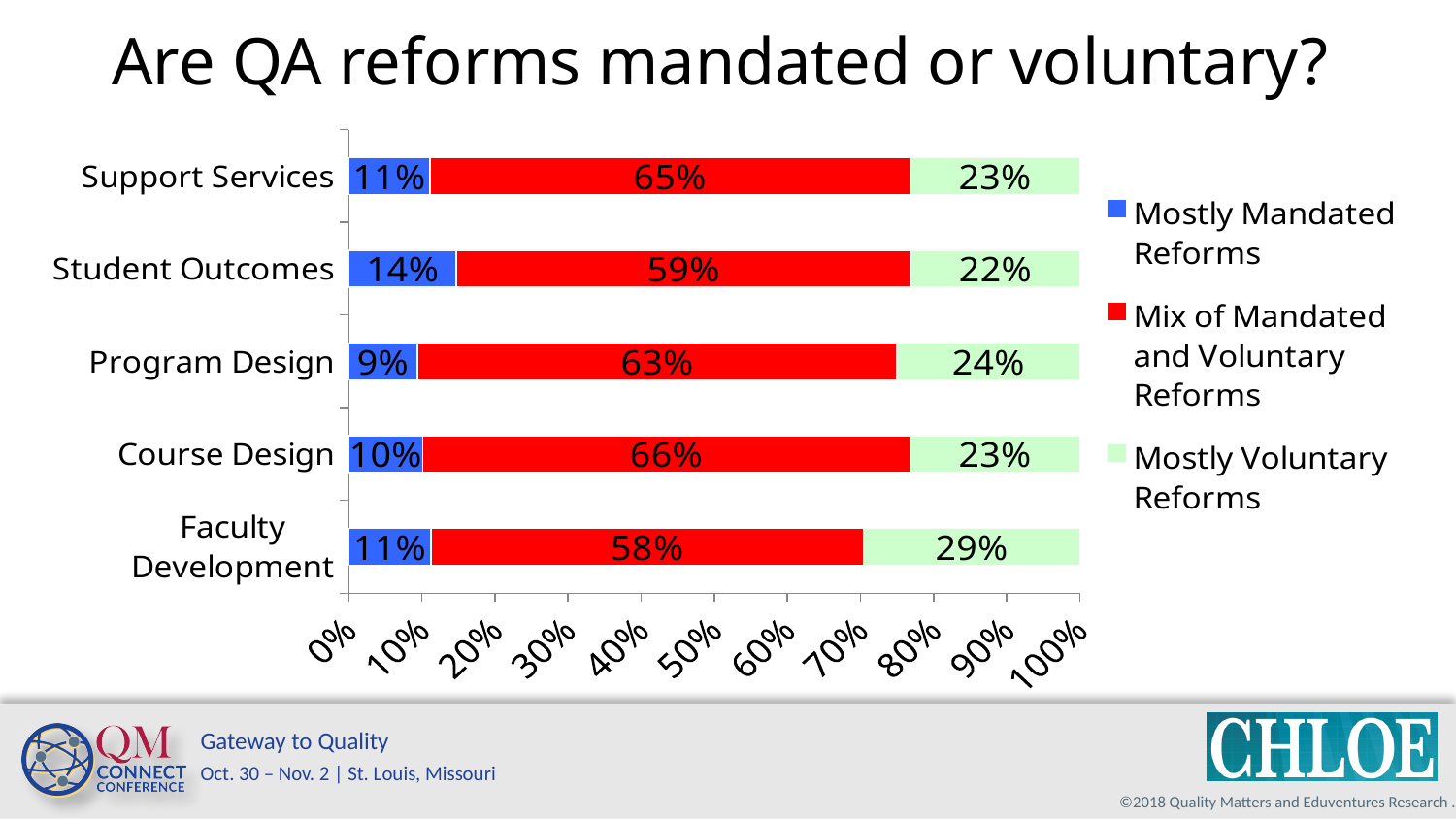
Which has a larger Mostly Voluntary Reforms share, Program Design or Support Services? Program Design What kind of chart is shown on the slide? Stacked bar chart What percentage of Course Design QA reforms are a mix of mandated and voluntary reforms? 66% How many categories are shown on the chart? 5 Which category has the highest share of Mostly Voluntary Reforms? Faculty Development What percentage of Faculty Development QA reforms are mostly voluntary? 29% What percentage of Student Outcomes QA reforms are mostly mandated? 14% How many series does the legend list? 3 Which category has the lowest share of Mix of Mandated and Voluntary Reforms? Faculty Development Which category has the lowest share of Mostly Mandated Reforms? Program Design Which category has the highest share of Mostly Mandated Reforms? Student Outcomes How many percentage points higher is the Mix of Mandated and Voluntary Reforms share for Course Design than for Faculty Development? 8 percentage points